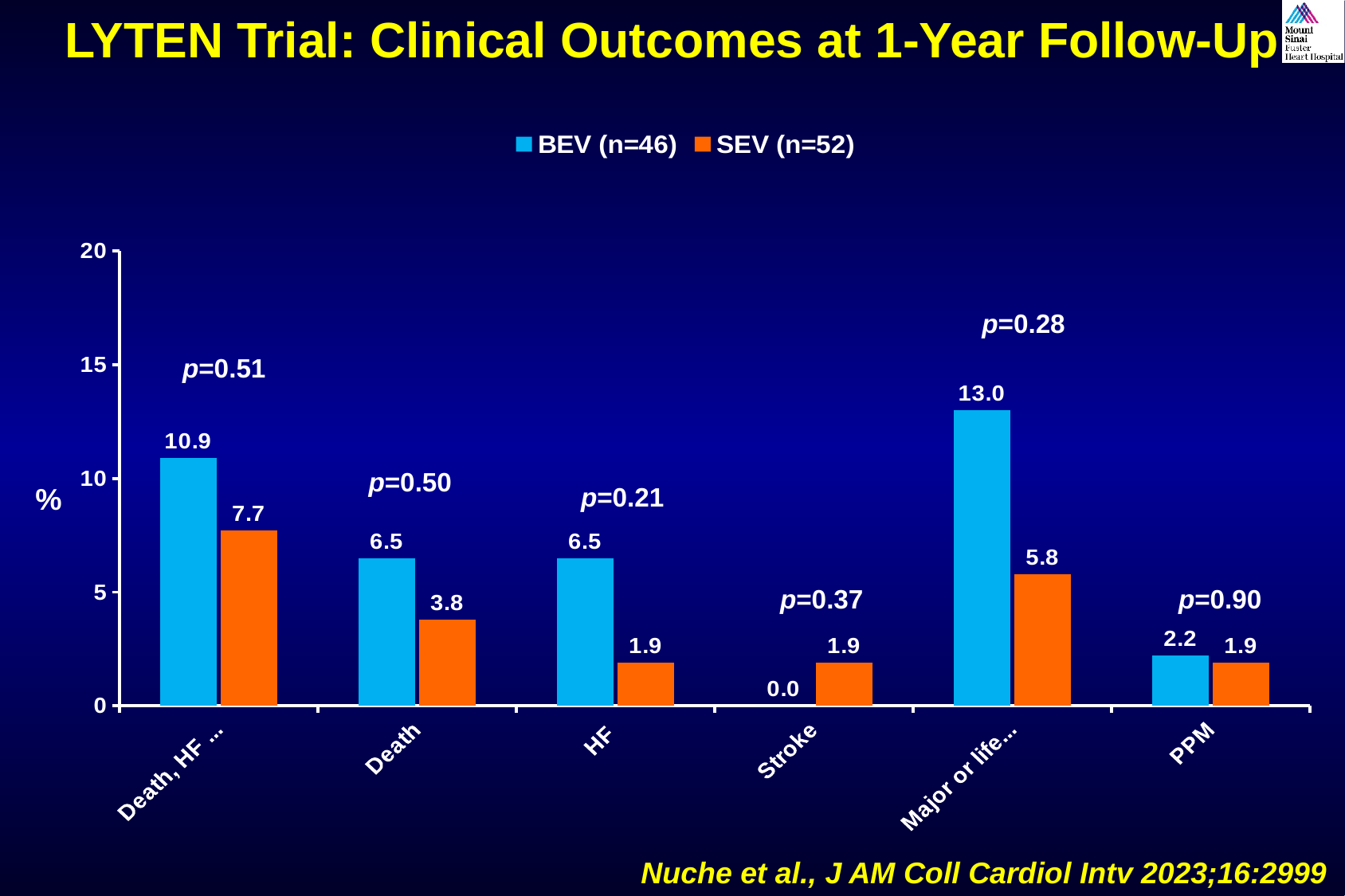
What is the value for BEV (n=46) in the Death category? 6.5 Which category has the lowest BEV (n=46) value? Stroke What is the value for SEV (n=52) in the HF category? 1.9 Which category has the highest BEV (n=46) value? Major or life... (the fifth category) What kind of chart is shown on the slide? Bar chart What is the difference between the BEV (n=46) and SEV (n=52) values in the Death category? 2.7 How many series does the legend list? 2 In the HF category, which series has the larger value, BEV (n=46) or SEV (n=52)? BEV (n=46) Is the BEV (n=46) value in the fifth category (Major or life...) greater or less than 10? greater What is the value for BEV (n=46) in the Stroke category? 0.0 What is the value for SEV (n=52) in the PPM category? 1.9 How many categories are shown on the x axis? 6